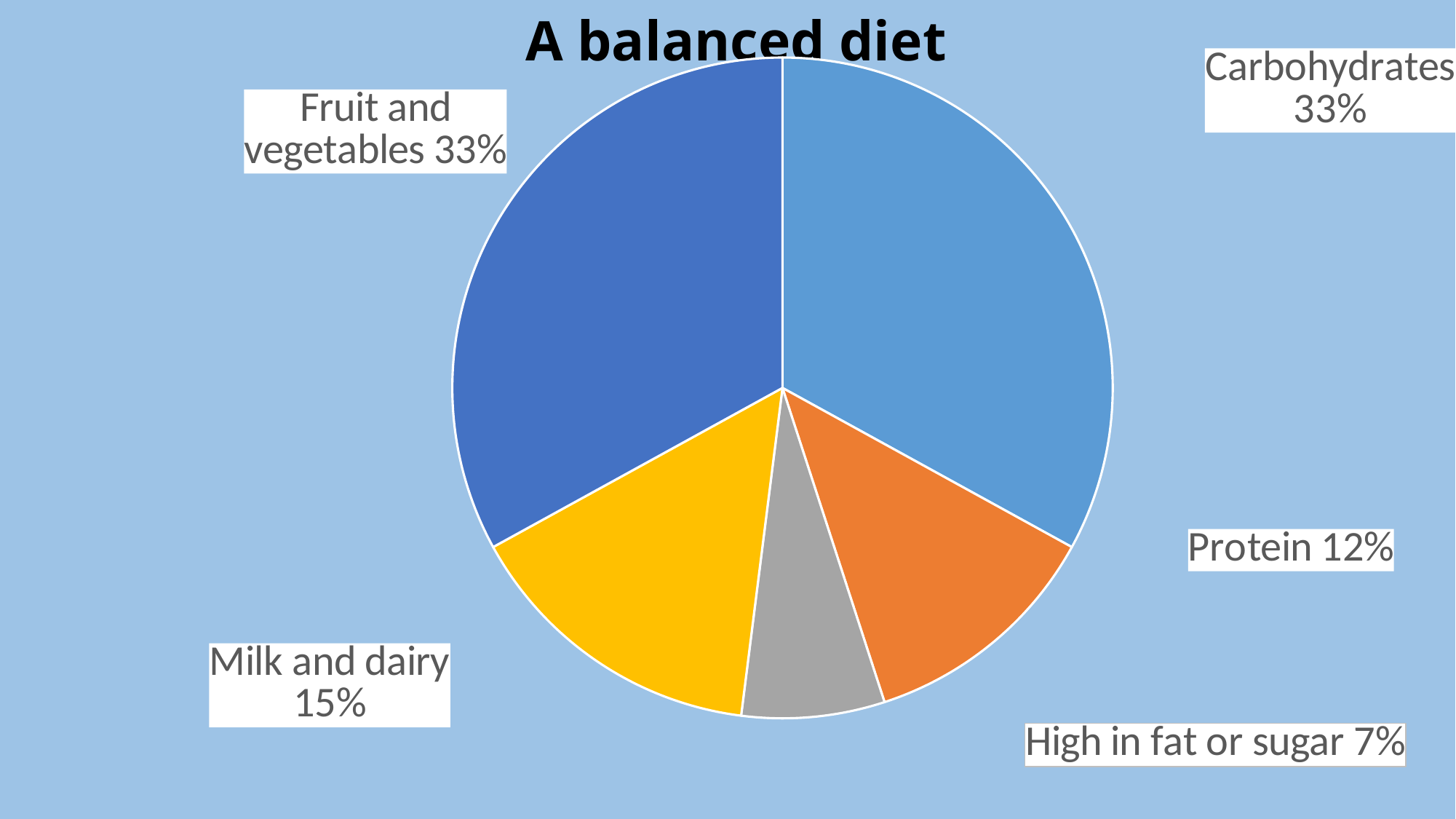
What is the title of the chart? A balanced diet What share of the pie is High in fat or sugar? 7% What kind of chart is shown on the slide? Pie chart What share of the pie is Milk and dairy? 15% Which category has the smallest slice of the pie? High in fat or sugar What share of the pie is Carbohydrates? 33% Which is larger, the Milk and dairy slice or the Protein slice? Milk and dairy Which is larger, the Fruit and vegetables slice or the High in fat or sugar slice? Fruit and vegetables What share of the pie is Protein? 12% What is the difference between the Milk and dairy share and the Protein share? 3% What is the difference between the Carbohydrates share and the High in fat or sugar share? 26% How many categories are shown in the pie chart? 5